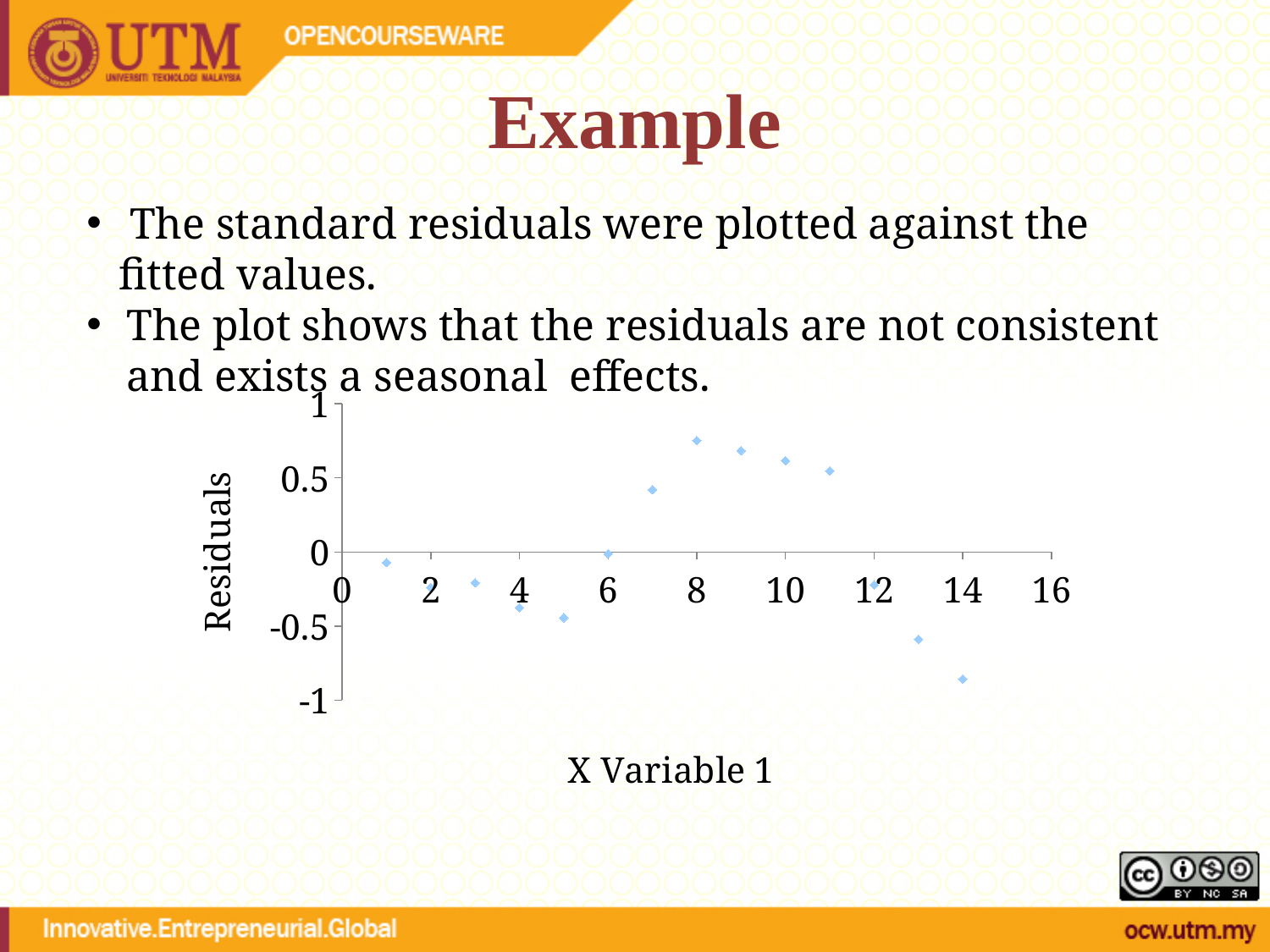
Is the residual at x = 8 greater or less than 0.5? greater Is the residual at x = 5 greater or less than 0? less Which has the larger residual, x = 10 or x = 4? x = 10 Is the residual at x = 14 greater or less than -0.5? less What is the label of the horizontal axis of the chart? X Variable 1 Which has the larger residual, x = 14 or x = 8? x = 8 At which x value is the residual highest? 8 What kind of chart is shown on the slide? Scatter plot What is the label of the vertical axis of the chart? Residuals At which x value is the residual lowest? 14 How many data points are plotted on the chart? 14